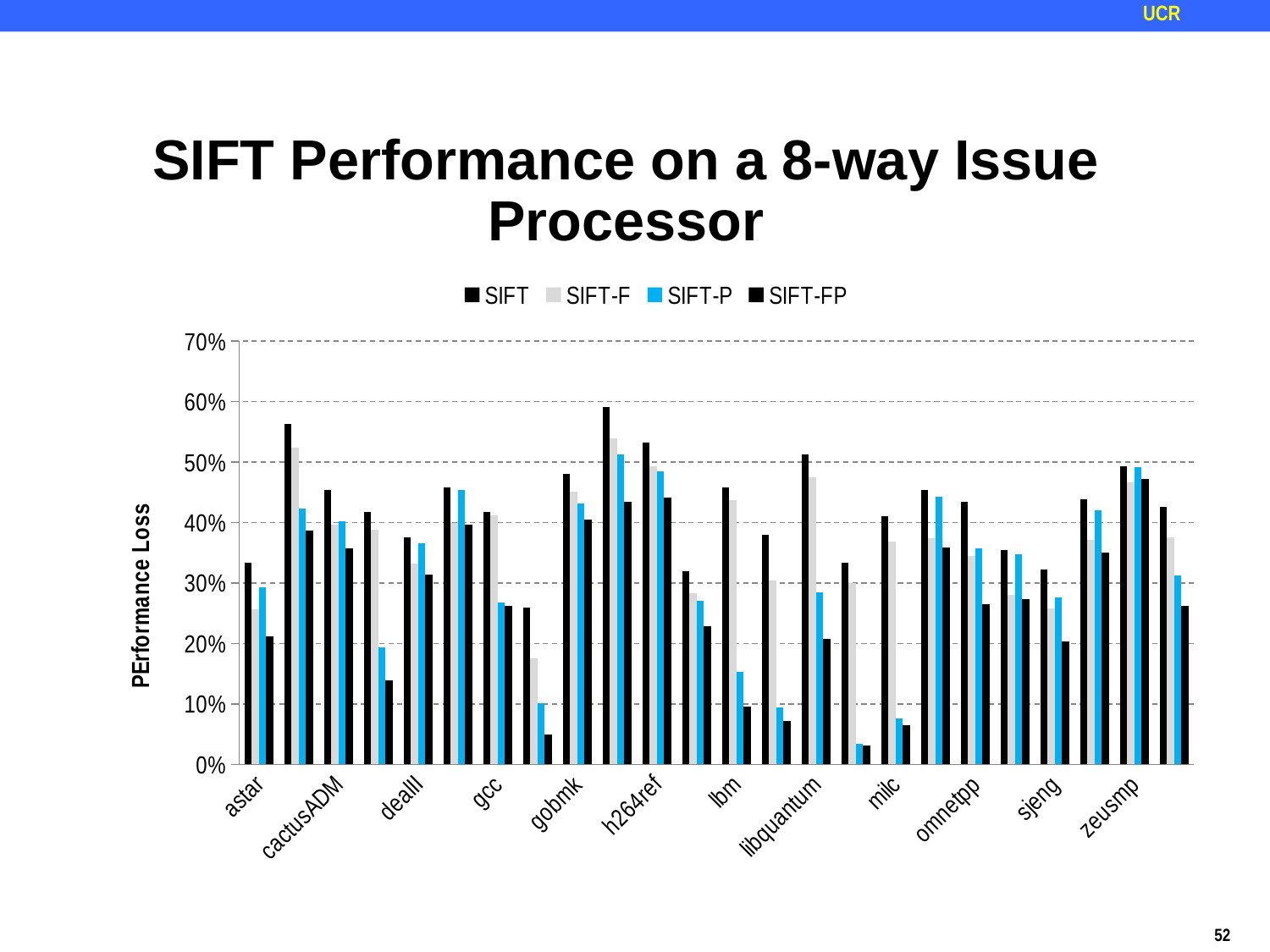
How many series does the legend list? 4 Is the SIFT-FP value for astar greater or less than 30%? less How many category labels are shown along the x axis? 12 What is the label on the y axis? PErformance Loss What kind of chart is shown on the slide? bar chart Is the SIFT-F value for astar greater or less than 30%? less Is the SIFT value for astar greater or less than 30%? greater For astar, which is larger, the SIFT value or the SIFT-FP value? SIFT What is the title of the chart? SIFT Performance on a 8-way Issue Processor